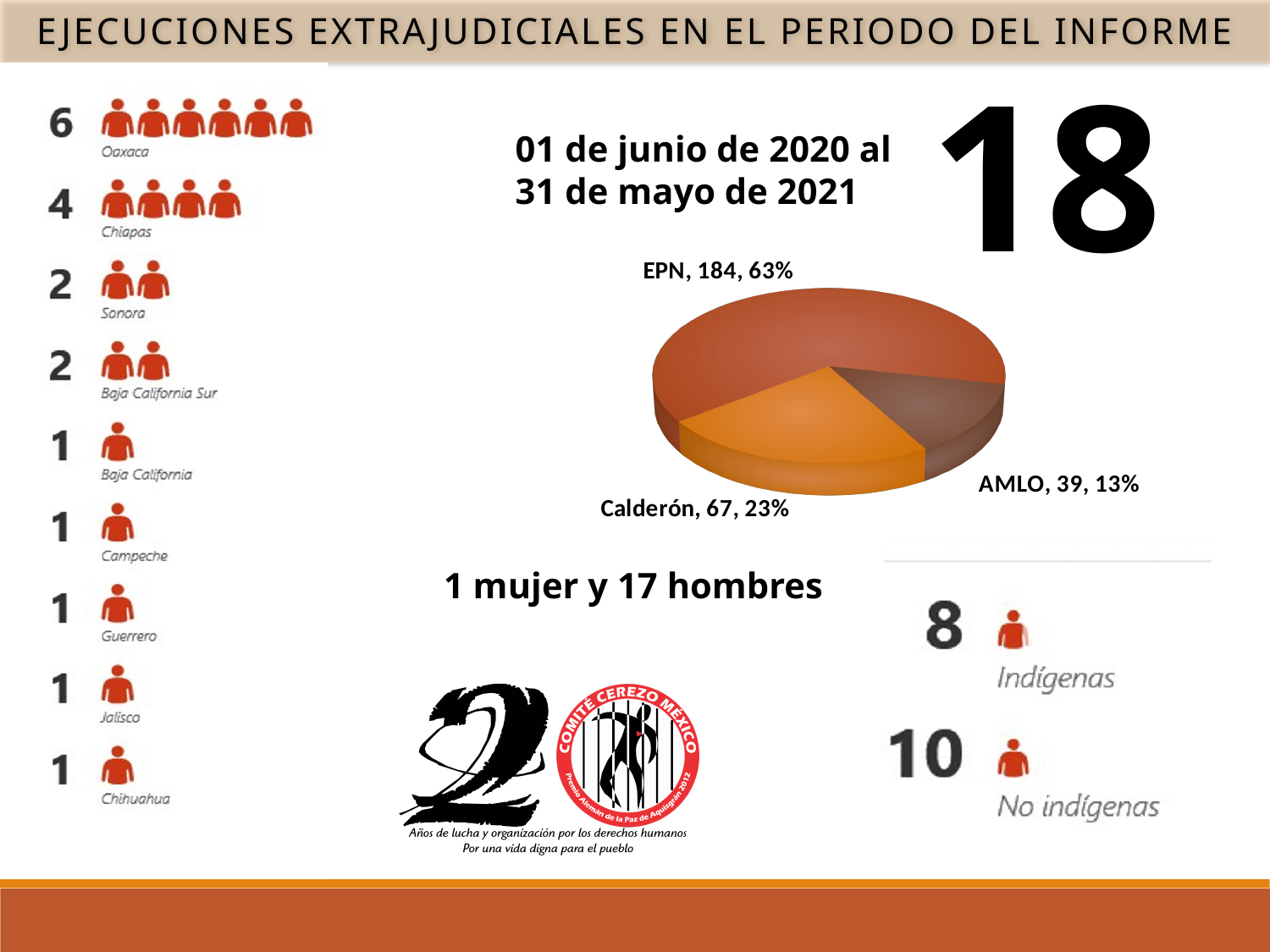
In the pictograph on the left, which state has the highest value? Oaxaca What kind of chart is shown in the centre of the slide? Pie chart In the pie chart, what value is shown for EPN? 184 In the pictograph at the bottom right, what value is shown for No indígenas? 10 In the pictograph on the left, how many figures are shown for Oaxaca? 6 In the pie chart, what percentage share is shown for Calderón? 23% In the pie chart, which slice is the smallest? AMLO In the pie chart, which slice is the largest? EPN In the pie chart, which is larger, the Calderón value or the AMLO value? Calderón How many slices does the pie chart have? 3 In the pie chart, what is the difference between the EPN value and the Calderón value? 117 In the pie chart, what value is shown for AMLO? 39